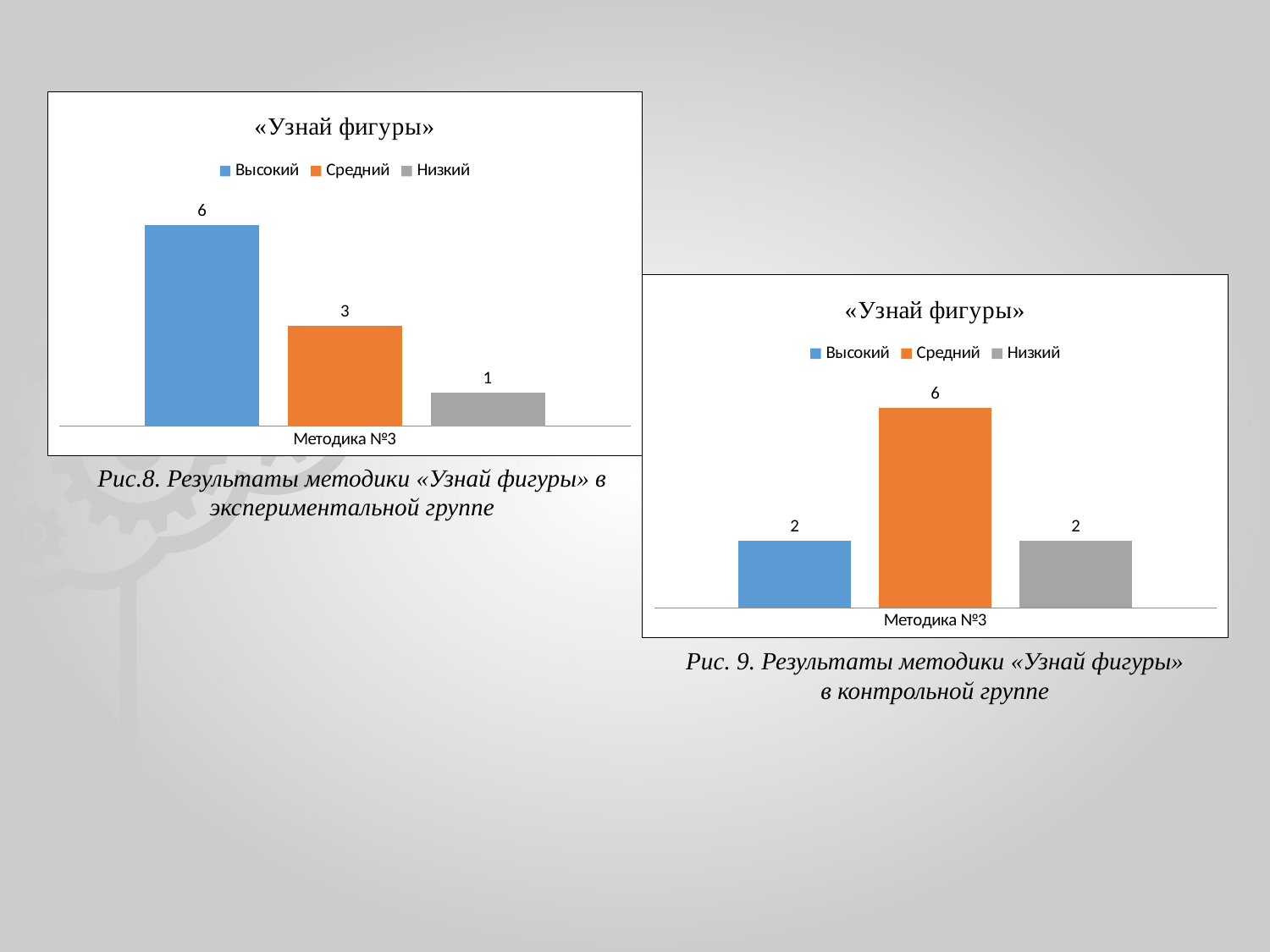
In the left chart (Рис.8, experimental group), which is larger: Средний or Низкий? Средний In the left chart (Рис.8, experimental group), which series has the highest value? Высокий In the left chart (Рис.8, experimental group), which series has the lowest value? Низкий In the left chart (Рис.8, experimental group), what is the value for Высокий? 6 In the right chart (Рис. 9, control group), which series has the highest value? Средний In the left chart (Рис.8, experimental group), what is the value for Низкий? 1 In the left chart (Рис.8, experimental group), what is the difference between Высокий and Средний? 3 How many series does the legend of the right chart (Рис. 9, control group) list? 3 What kind of chart is the left chart (Рис.8, experimental group)? Bar chart In the right chart (Рис. 9, control group), what is the value for Средний? 6 In the right chart (Рис. 9, control group), what is the difference between Средний and Низкий? 4 In the right chart (Рис. 9, control group), what is the value for Высокий? 2